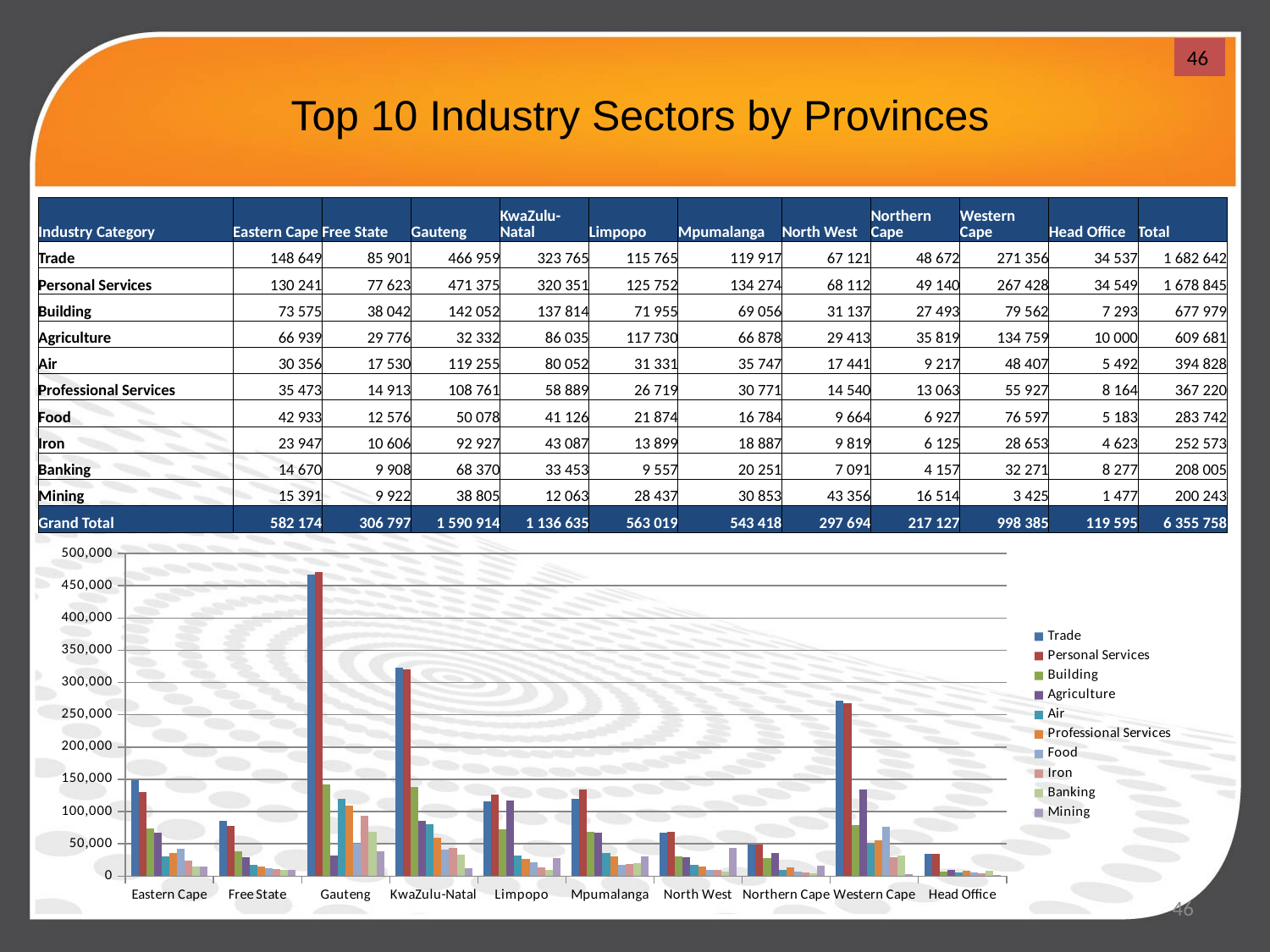
Is the Trade value for Western Cape greater or less than 250,000? greater How many series does the chart's legend list? 10 What is the difference between the Trade value for Gauteng and the Trade value for KwaZulu-Natal? 143 194 Which series is listed first in the chart's legend? Trade Is the Mining value for North West greater or less than 50,000? less What kind of chart is shown on the slide? bar chart Which is larger, the Trade value for KwaZulu-Natal or the Trade value for Western Cape? KwaZulu-Natal Which category on the x axis has the tallest bars in the chart? Gauteng Is the Agriculture value for Western Cape greater or less than 100,000? greater Which category has the lowest Trade bar in the chart? Head Office How many categories are shown along the x axis of the chart? 10 What is the Trade value for Gauteng? 466 959